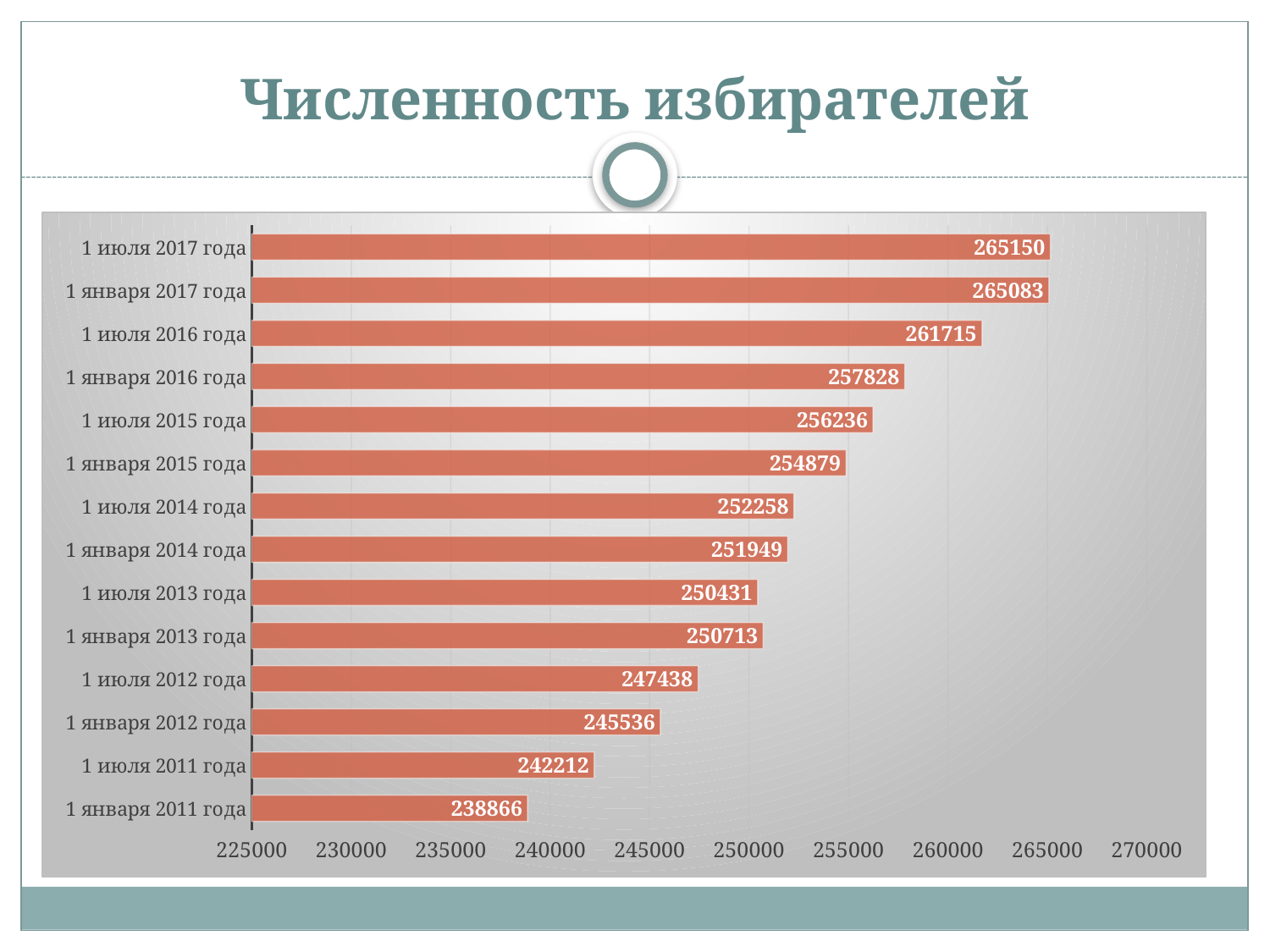
What is the value for 1 января 2011 года? 238866 Which is larger, the value for 1 января 2013 года or the value for 1 июля 2013 года? 1 января 2013 года Is the value for 1 июля 2014 года greater or less than 250000? greater What is the difference between the values for 1 июля 2017 года and 1 января 2011 года? 26284 What is the difference between the values for 1 июля 2016 года and 1 января 2016 года? 3887 What is the title of the chart? Численность избирателей Which category has the lowest value? 1 января 2011 года What is the value for 1 июля 2017 года? 265150 What is the value for 1 января 2014 года? 251949 How many categories are shown in the chart? 14 Which category has the highest value? 1 июля 2017 года What kind of chart is shown on the slide? bar chart